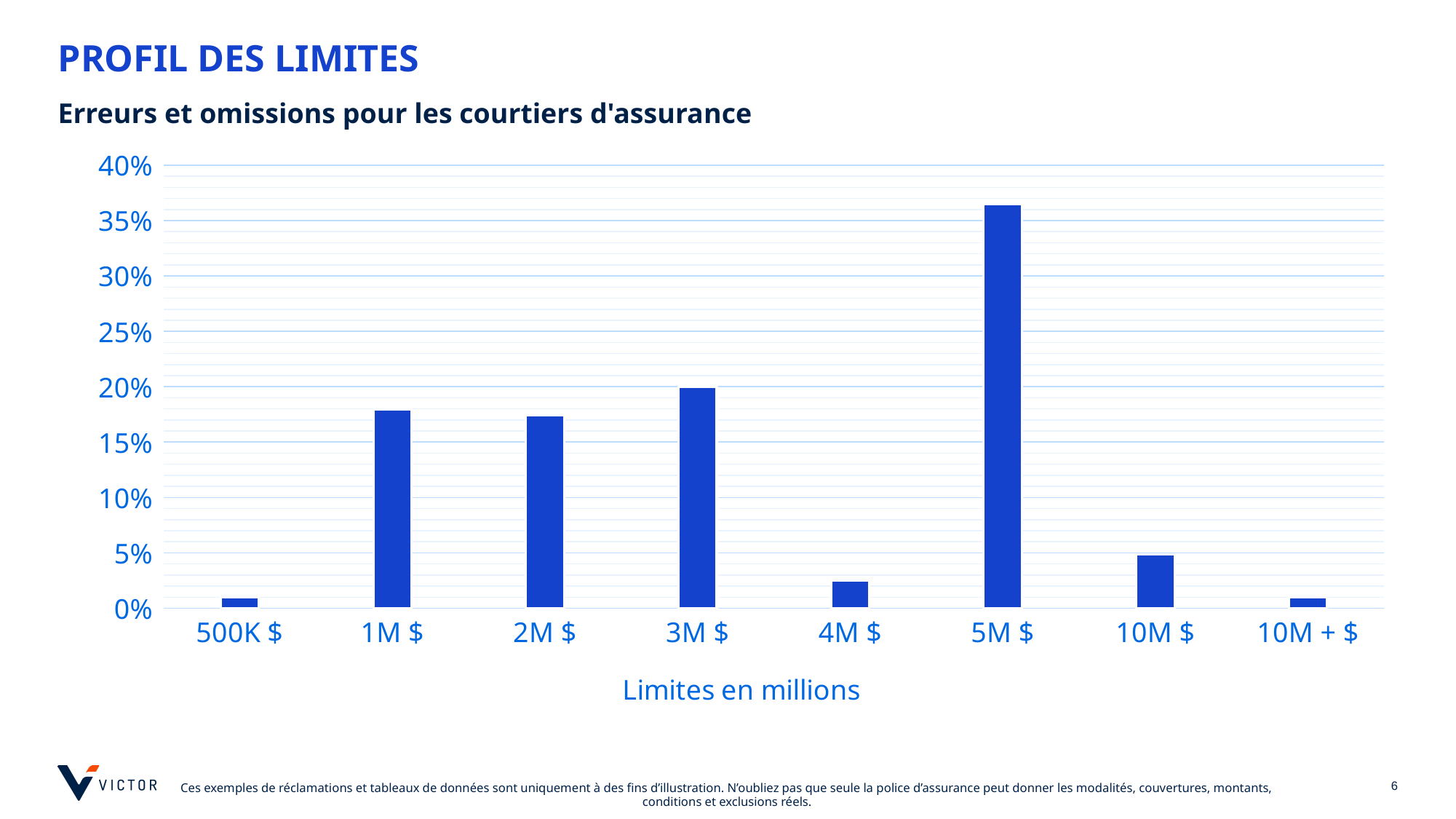
What is the highest value shown on the y axis? 40% Which is larger, the value for 1M $ or the value for 4M $? 1M $ Is the value for 5M $ greater or less than 35%? greater Which is larger, the value for 5M $ or the value for 3M $? 5M $ Is the value for 4M $ greater or less than 5%? less What kind of chart is shown on the slide? bar chart How many limit categories are shown on the x axis? 8 What is the title of the x axis? Limites en millions Which limit category has the highest value? 5M $ Is the value for 1M $ greater or less than 15%? greater